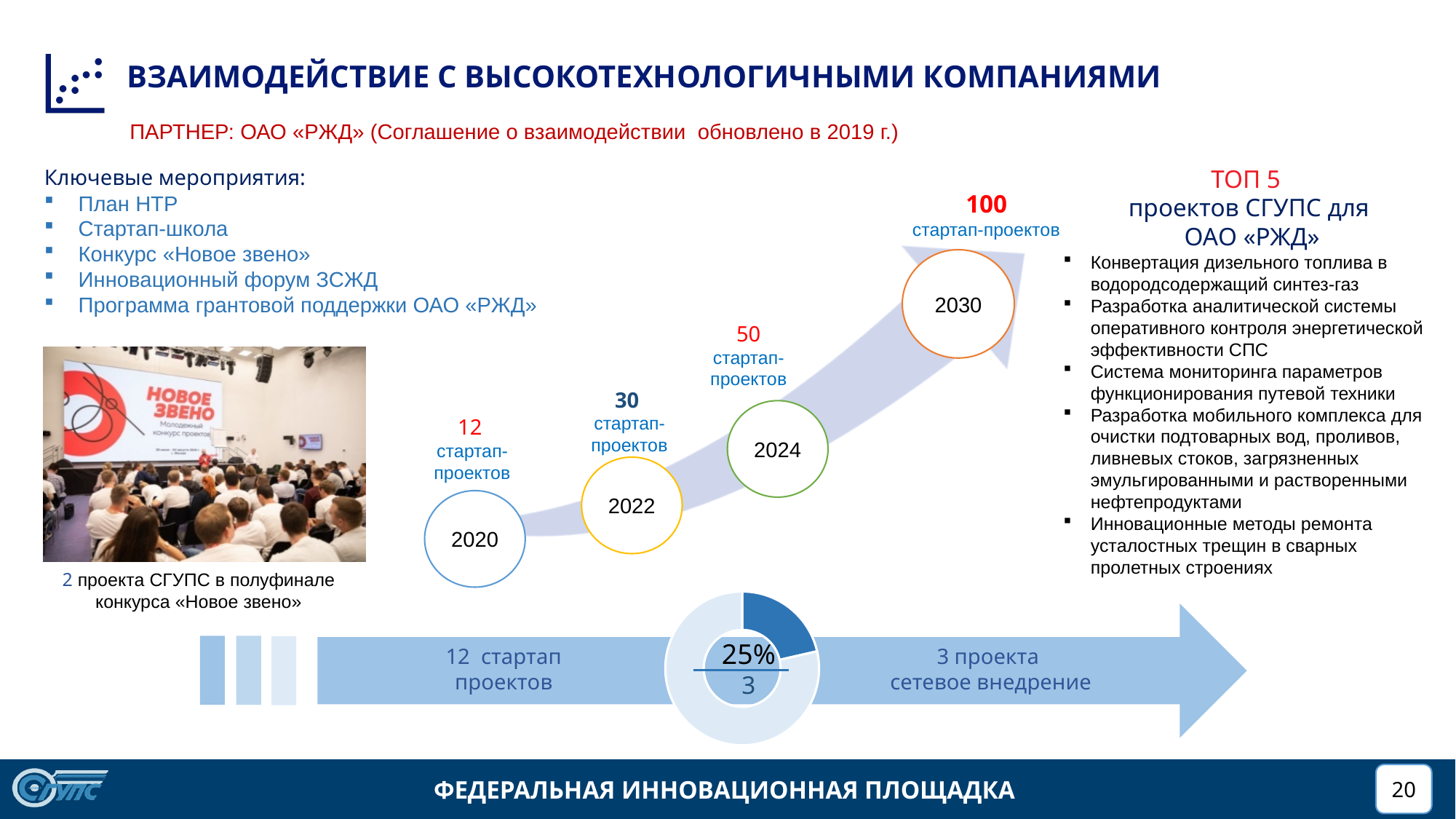
On the timeline chart, how many startup projects are shown for 2024? 50 On the timeline chart, how many startup projects are shown for 2022? 30 What kind of chart is the circular chart at the bottom of the slide? doughnut chart On the timeline chart, how many startup projects are shown for 2030? 100 On the timeline chart, which year has the lowest number of startup projects? 2020 What percentage is shown in the centre of the doughnut chart at the bottom of the slide? 25% On the timeline chart, how many startup projects are shown for 2020? 12 On the timeline chart, what is the difference between the number of startup projects in 2022 and in 2020? 18 On the timeline chart, what is the difference between the number of startup projects in 2030 and in 2024? 50 On the timeline chart, which year has the highest number of startup projects? 2030 On the timeline chart, do the numbers of startup projects rise or fall from 2020 to 2030? rise How many year points are shown on the timeline chart? 4